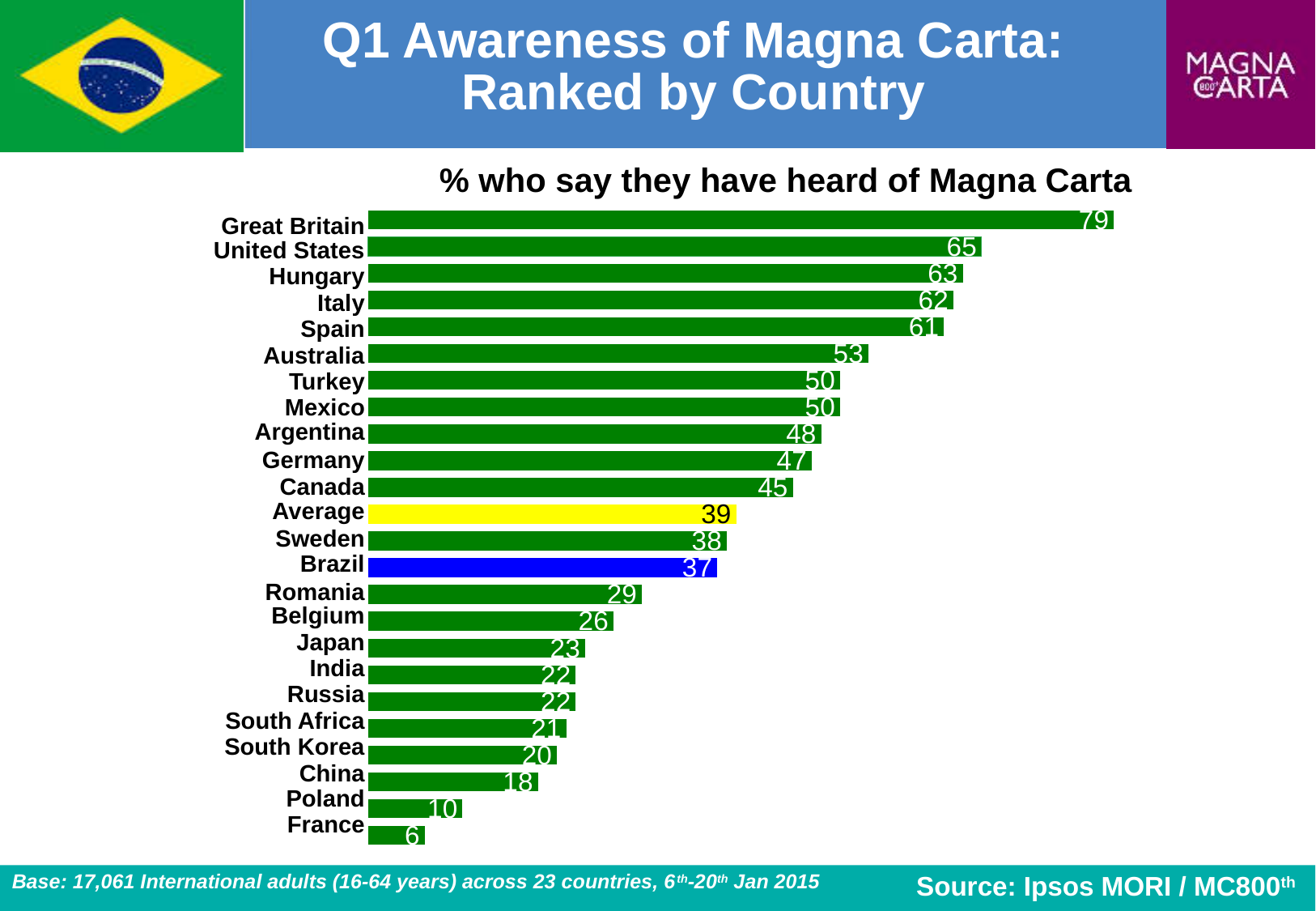
What type of chart is shown on the slide? Bar chart What is the difference between the values for Great Britain and the United States? 14 What colour is the bar for Brazil? Blue Which has a higher value, Australia or Canada? Australia How much higher is the value for Sweden than the value for Brazil? 1 Which has a higher value, Poland or China? China Which country has the highest percentage who say they have heard of Magna Carta? Great Britain What is the value shown for the Average bar? 39 What value is shown for Hungary? 63 How many bars are plotted on the chart, including the Average bar? 24 Which country has the lowest percentage who say they have heard of Magna Carta? France What percentage of people in Brazil say they have heard of Magna Carta? 37